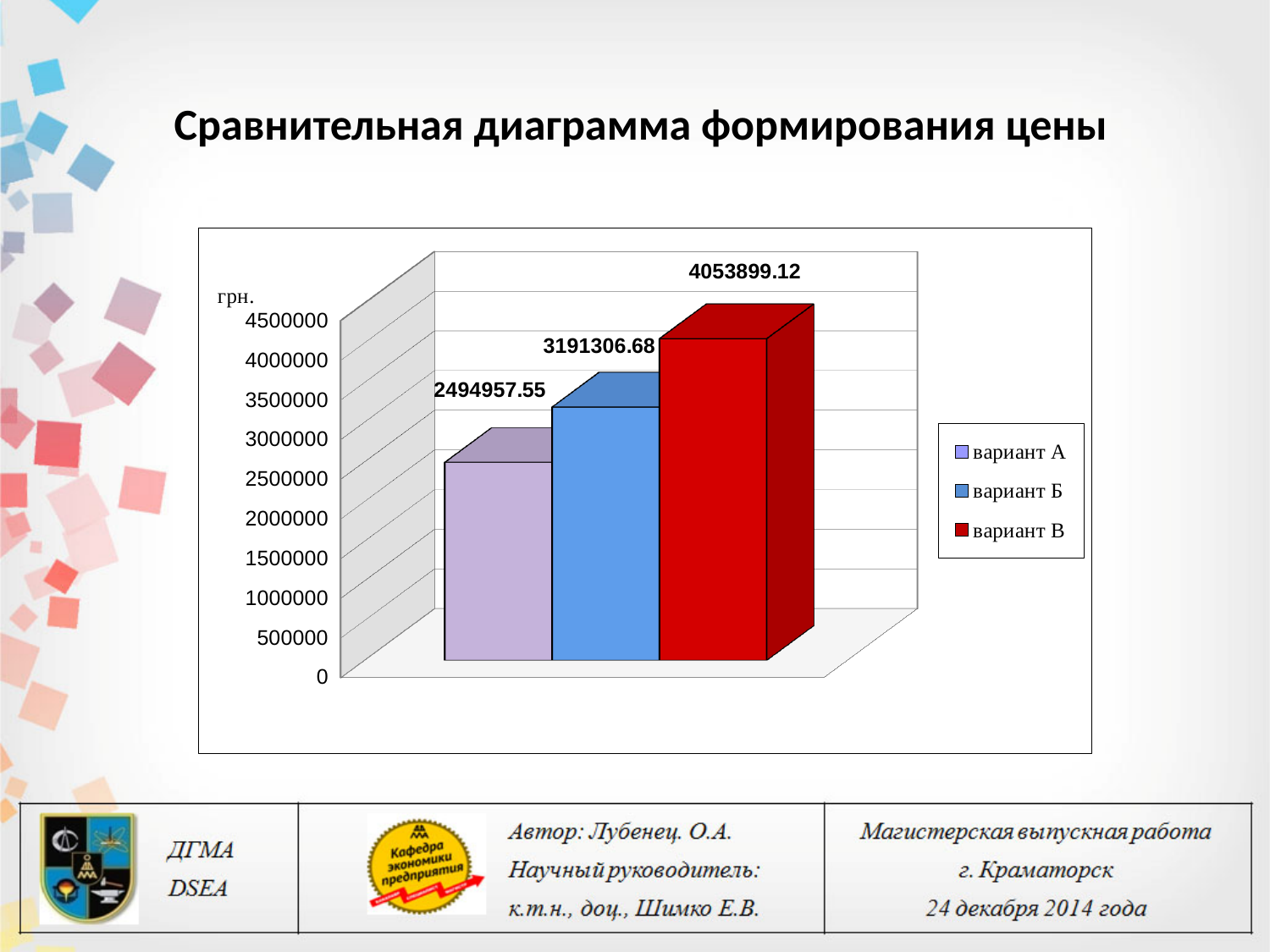
What is the difference between the values for вариант Б and вариант А? 696349.13 What is the value for вариант А? 2494957.55 Is the value for вариант В greater or less than 4000000? greater Which is larger, the value for вариант А or the value for вариант Б? вариант Б What is the title of the chart? Сравнительная диаграмма формирования цены What is the difference between the values for вариант В and вариант Б? 862592.44 How many series does the legend list? 3 What is the value for вариант Б? 3191306.68 What is the value for вариант В? 4053899.12 Which variant has the lowest value? вариант А Which variant has the highest value? вариант В What type of chart is shown on the slide? bar chart